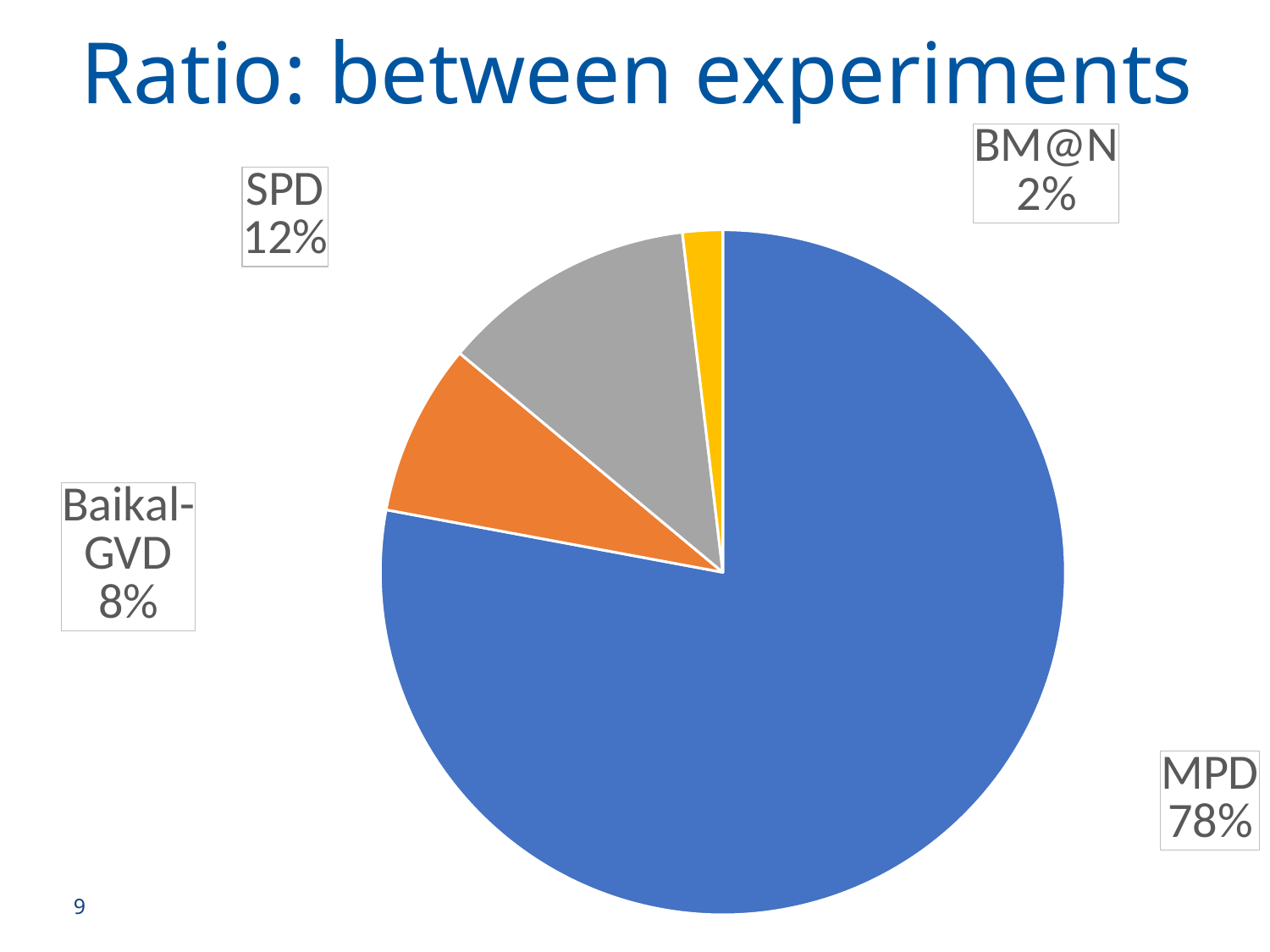
What share of the pie does Baikal-GVD have? 8% Which experiment has the smallest share of the pie? BM@N What colour is the MPD slice? blue What share of the pie does SPD have? 12% What kind of chart is shown on the slide? pie chart Which has a larger share, SPD or Baikal-GVD? SPD What is the difference in percentage points between the SPD share and the Baikal-GVD share? 4 How many slices does the pie chart have? 4 What share of the pie does MPD have? 78% Which experiment has the largest share of the pie? MPD What is the title of the chart? Ratio: between experiments